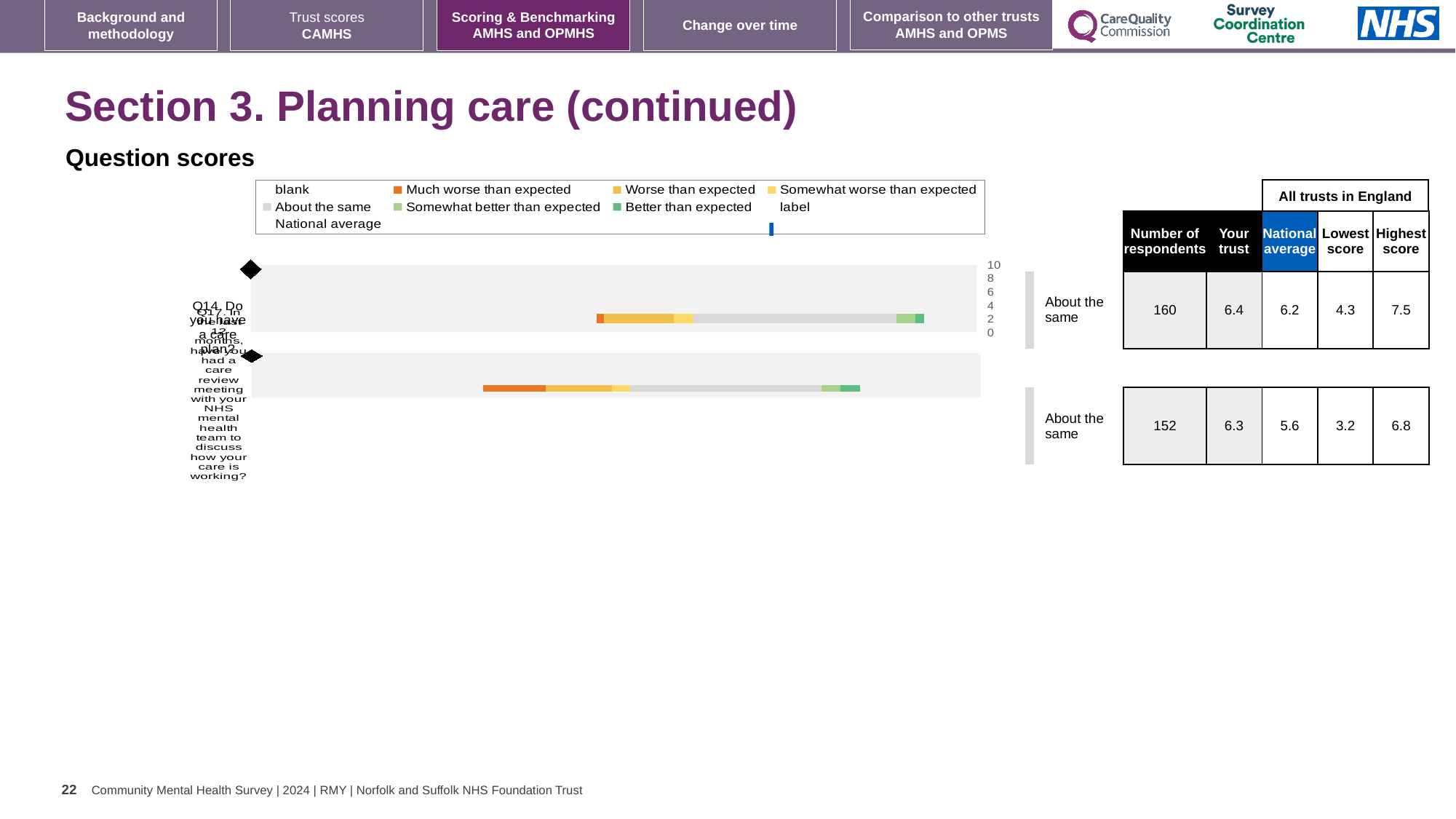
According to the table beside the chart, what is the national average for Q14? 6.2 According to the table beside the chart, what is the 'Your trust' score for Q17? 6.3 According to the table beside the chart, which question has the higher 'Your trust' score, Q14 or Q17? Q14 According to the table beside the chart, what is the difference between the 'Your trust' score and the national average for Q17? 0.7 Which legend entry is shown in orange? Much worse than expected According to the table beside the chart, what is the national average for Q17? 5.6 According to the table beside the chart, how many respondents answered Q14? 160 How many survey questions are plotted as bars in the chart? 2 What kind of chart is shown under 'Question scores'? bar chart Which two questions are plotted in the chart? Q14 and Q17 According to the table beside the chart, what is the 'Your trust' score for Q14? 6.4 According to the table beside the chart, how many respondents answered Q17? 152